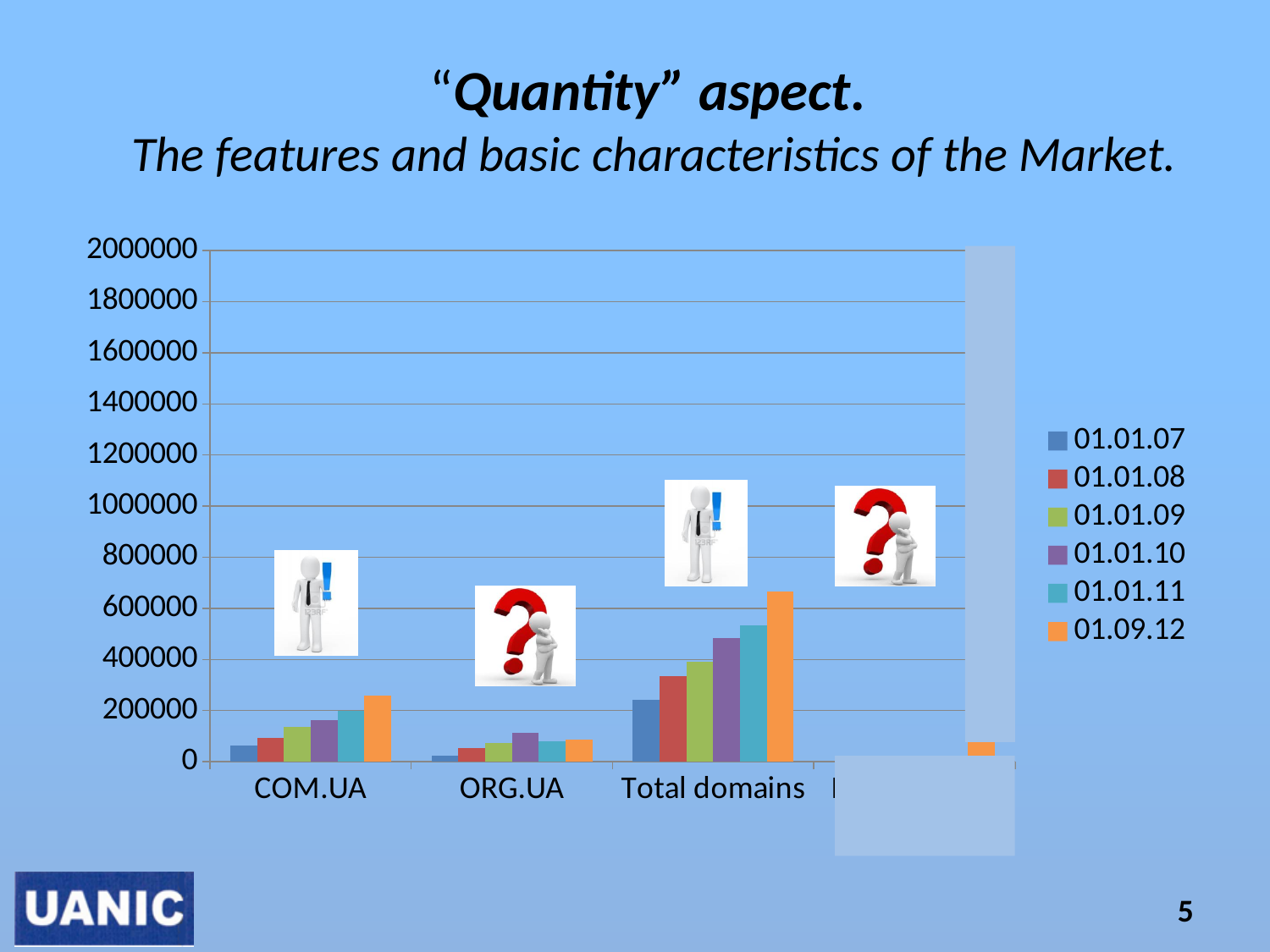
Which series is listed last in the legend? 01.09.12 For the COM.UA category, which series has the lowest value? 01.01.07 For the Total domains category, which series has the highest value? 01.09.12 Is the value for ORG.UA in the 01.01.10 series greater or less than 200000? less For the Total domains category, do the values rise or fall from the 01.01.07 series to the 01.09.12 series? rise Which is larger for the 01.09.12 series: the value for COM.UA or the value for Total domains? Total domains Which series is listed first in the legend? 01.01.07 Is the value for COM.UA in the 01.09.12 series greater or less than 200000? greater What kind of chart is shown on the slide? bar chart Is the value for Total domains in the 01.09.12 series greater or less than 600000? greater How many series does the legend list? 6